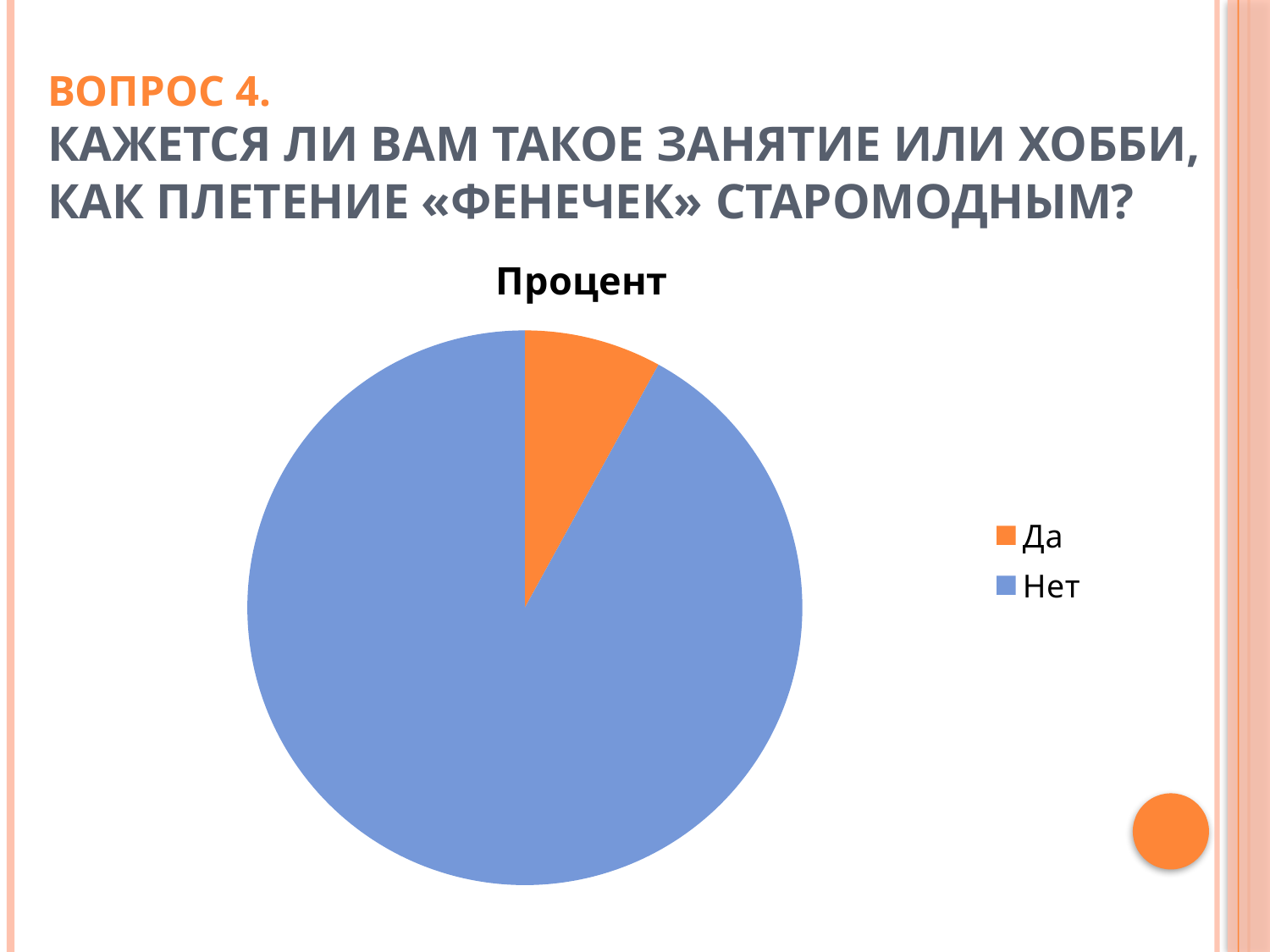
What is the title of the chart? Процент How many entries does the legend list? 2 How many slices does the pie chart have? 2 Which is larger, the slice for Да or the slice for Нет? Нет Is the share of the Да slice greater or less than 25%? less Which slice is the smallest in the pie chart? Да Which slice is the largest in the pie chart? Нет What kind of chart is shown on the slide? pie chart What colour is the slice for Да? orange Is the share of the Нет slice greater or less than 50%? greater